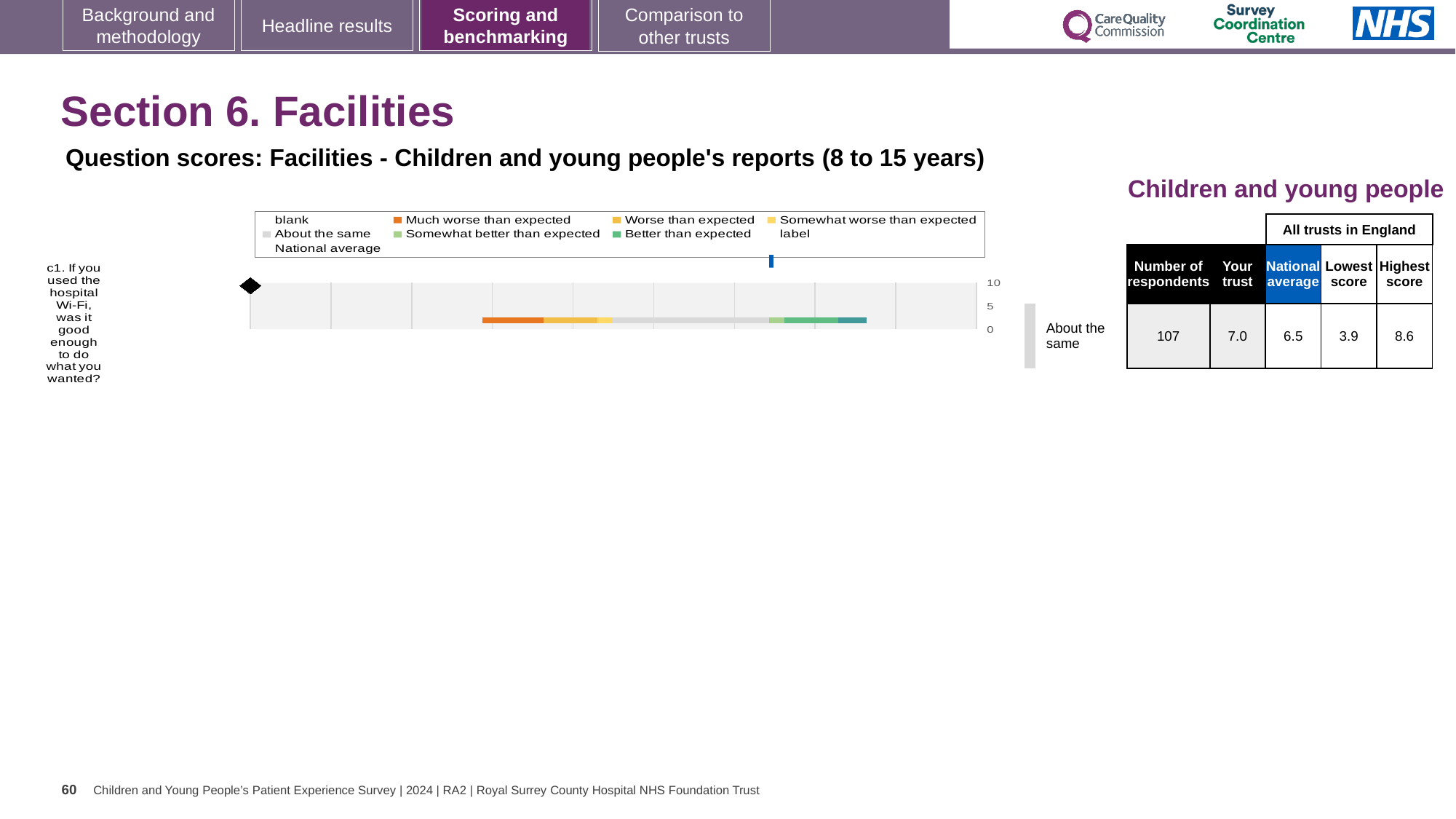
How many survey questions are plotted in the chart? 1 What is the highest score among all trusts in England for question c1? 8.6 What is the 'Your trust' score for question c1 about the hospital Wi-Fi? 7.0 Which is larger for question c1: the 'Your trust' score or the national average? Your trust What is the national average score for question c1 about the hospital Wi-Fi? 6.5 What kind of chart is shown on the slide? Bar chart Which survey question is plotted in the chart? c1. If you used the hospital Wi-Fi, was it good enough to do what you wanted? What is the difference between the highest score and the lowest score for question c1? 4.7 How many respondents answered question c1 about the hospital Wi-Fi? 107 How is the trust's result for question c1 categorised relative to expectations? About the same What is the lowest score among all trusts in England for question c1? 3.9 By how much does the 'Your trust' score exceed the national average for question c1? 0.5